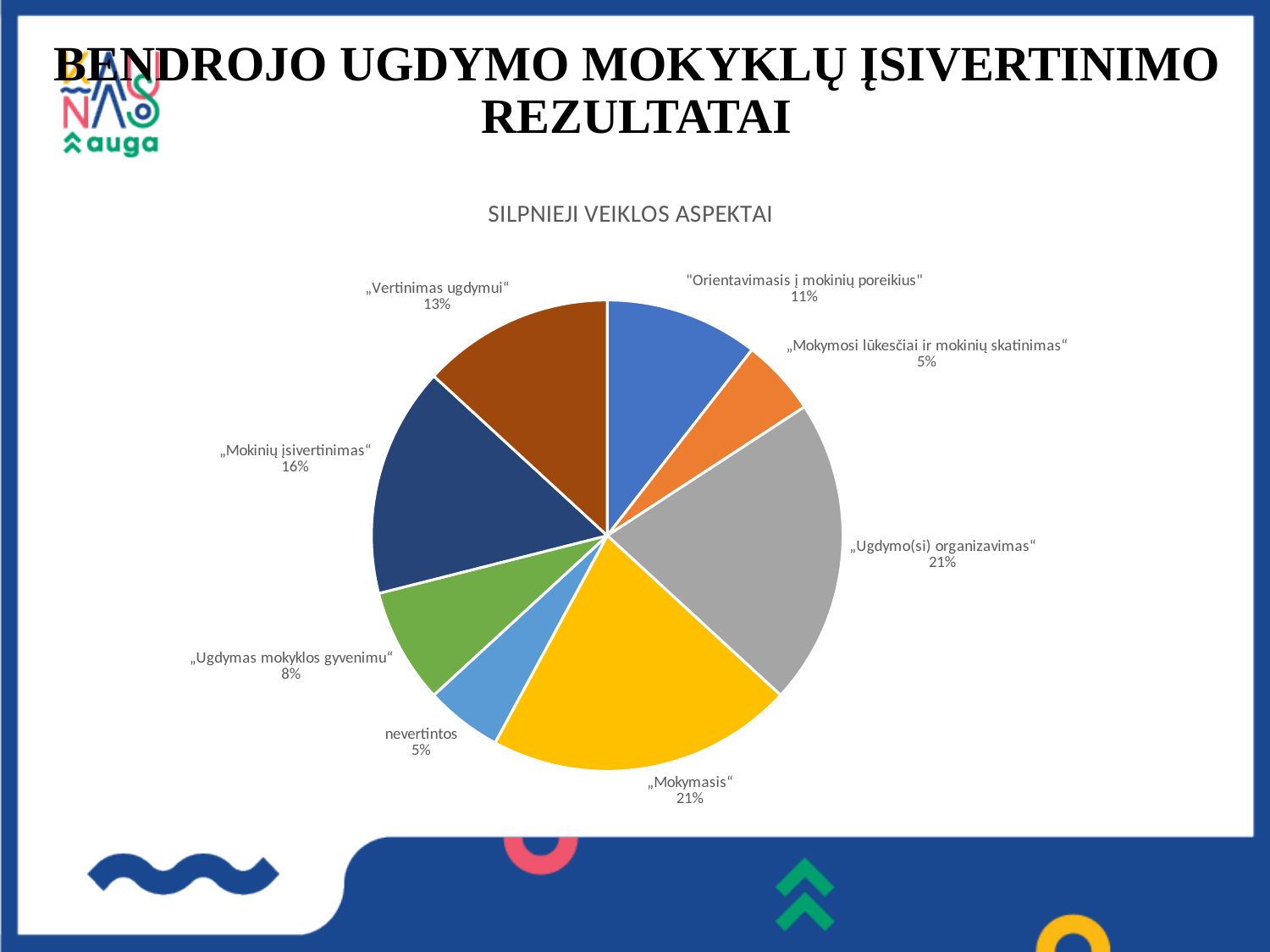
What is the difference in percentage points between "Mokinių įsivertinimas" and "Ugdymas mokyklos gyvenimu"? 8 What is the difference in percentage points between "Ugdymo(si) organizavimas" and "Vertinimas ugdymui"? 8 What kind of chart is shown on the slide? pie chart Which is larger, the share for "Mokymasis" or the share for "Mokinių įsivertinimas"? Mokymasis What share of the pie does "Mokinių įsivertinimas" have? 16% What share of the pie does "Ugdymo(si) organizavimas" have? 21% What share of the pie does "Vertinimas ugdymui" have? 13% What share of the pie does "Ugdymas mokyklos gyvenimu" have? 8% How many slices does the pie chart have? 8 What share of the pie does "Orientavimasis į mokinių poreikius" have? 11% What is the title of the chart? SILPNIEJI VEIKLOS ASPEKTAI What share of the pie does "nevertintos" have? 5%